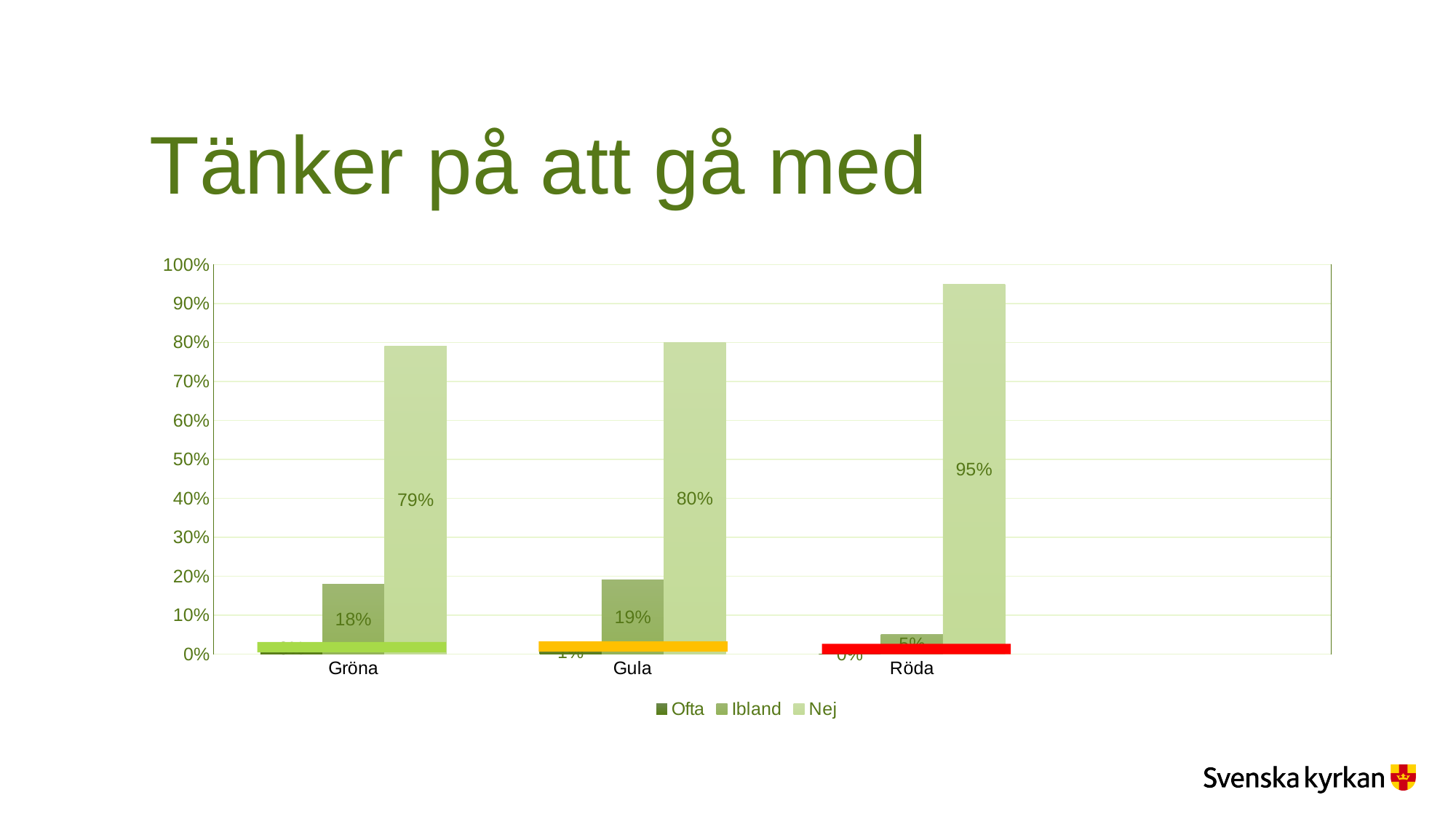
What is the difference between the Nej value for Röda and the Nej value for Gröna? 16% What kind of chart is shown on the slide? bar chart What is the value of Ibland for Gula? 19% What is the value of Ibland for Röda? 5% How many series does the legend list? 3 How many categories are shown on the x axis? 3 Which category has the highest Nej value? Röda What is the value of Nej for Gröna? 79% Is the Nej value for Gula greater or less than 50%? greater Which is larger, the Ibland value for Gröna or the Ibland value for Gula? Gula What is the value of Nej for Röda? 95% Which category has the lowest Ibland value? Röda